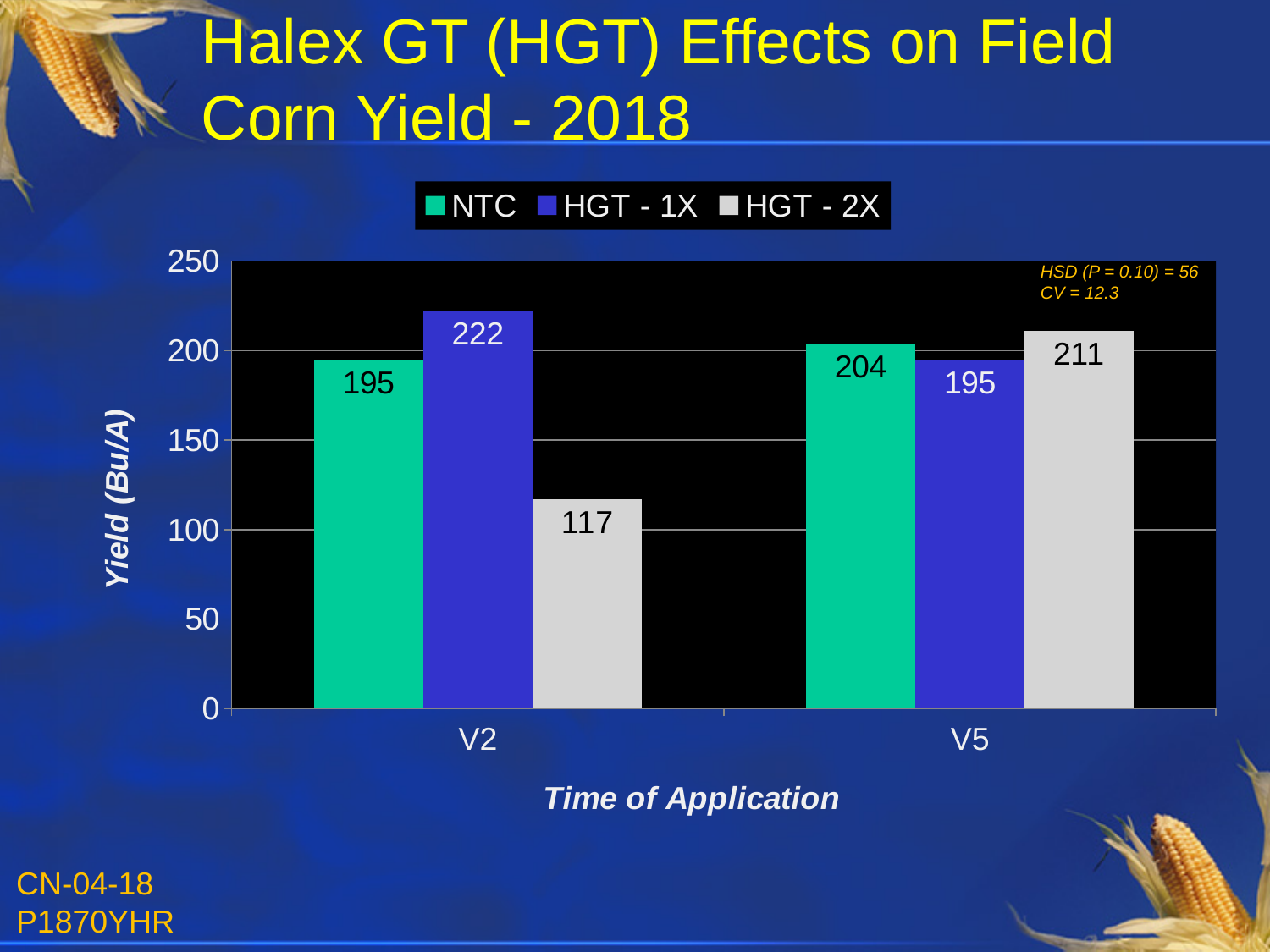
How many series does the legend list? 3 How many application times are shown on the x axis? 2 What is the yield for NTC at the V5 application time? 204 Which series has the lowest yield at V5? HGT - 1X What is the yield for HGT - 2X at the V2 application time? 117 What is the label of the y axis? Yield (Bu/A) What kind of chart is shown on the slide? Bar chart What is the yield for HGT - 1X at the V2 application time? 222 What is the difference in yield between HGT - 1X and HGT - 2X at V2? 105 What is the yield for HGT - 2X at the V5 application time? 211 Which series has the highest yield at V2? HGT - 1X Which is larger, the NTC yield at V5 or the NTC yield at V2? NTC at V5